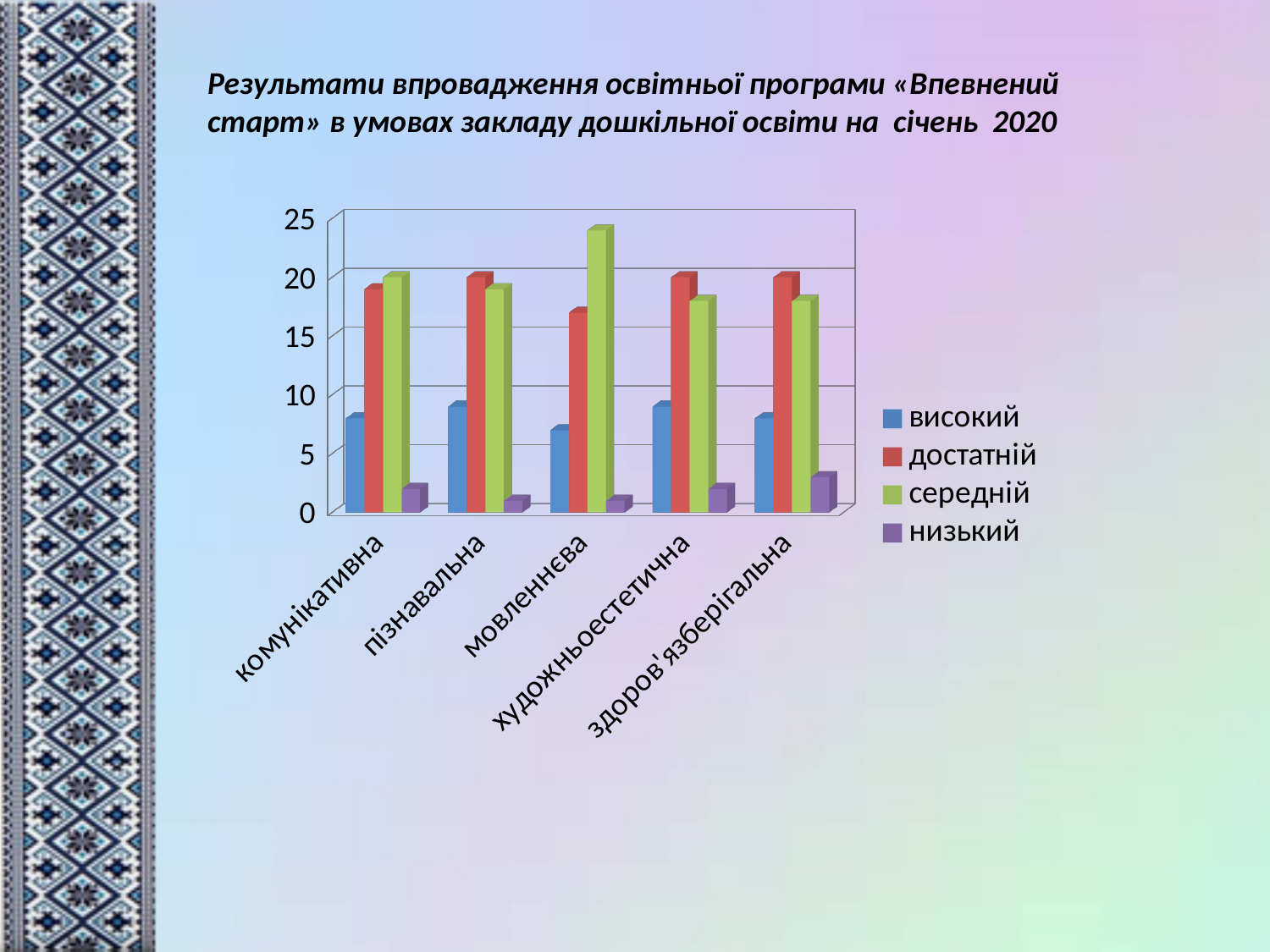
How many series does the legend list? 4 For мовленнєва, which is larger: «достатній» or «середній»? середній Which category has the highest value for the series «середній»? мовленнєва Is the value of «середній» for мовленнєва greater or less than 20? greater How many categories are shown along the x axis? 5 What kind of chart is shown on the slide? bar chart For комунікативна, which is larger: «високий» or «низький»? високий Is the value of «високий» for комунікативна greater or less than 10? less Is the value of «достатній» for мовленнєва greater or less than 15? greater Which category has the lowest value for the series «достатній»? мовленнєва Which series has the lowest values in every category? низький